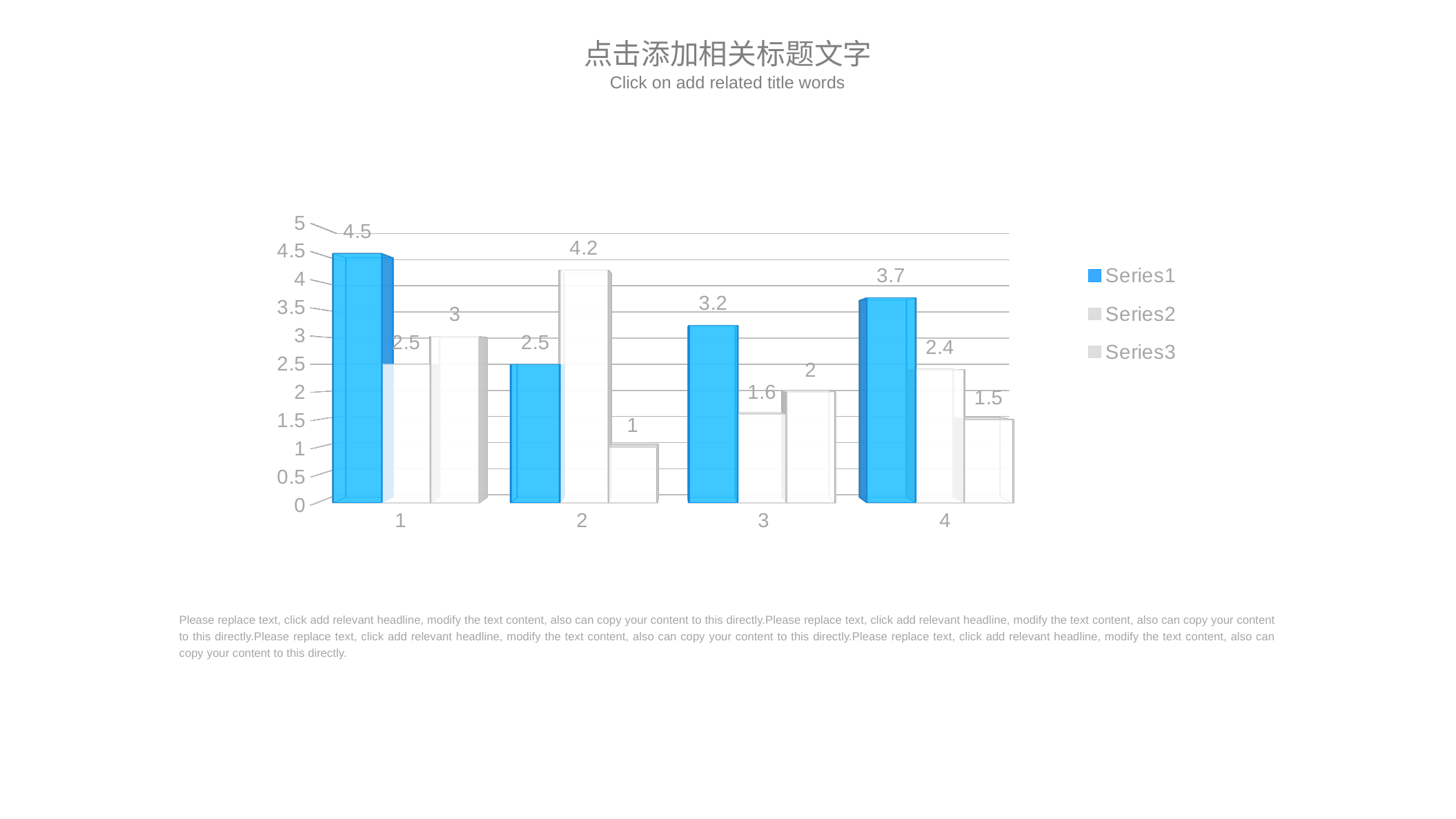
Which category has the lowest Series3 value? 2 Is the value of Series2 for category 4 greater or less than 2? greater What is the value of Series1 for category 4? 3.7 How many categories are shown on the x axis? 4 What is the value of Series1 for category 1? 4.5 For category 2, which is larger, Series1 or Series2? Series2 What is the value of Series3 for category 3? 2 How many series does the legend list? 3 What is the value of Series2 for category 2? 4.2 Which category has the highest Series1 value? 1 What is the difference between the Series1 value and the Series2 value for category 1? 2 What kind of chart is shown on the slide? bar chart